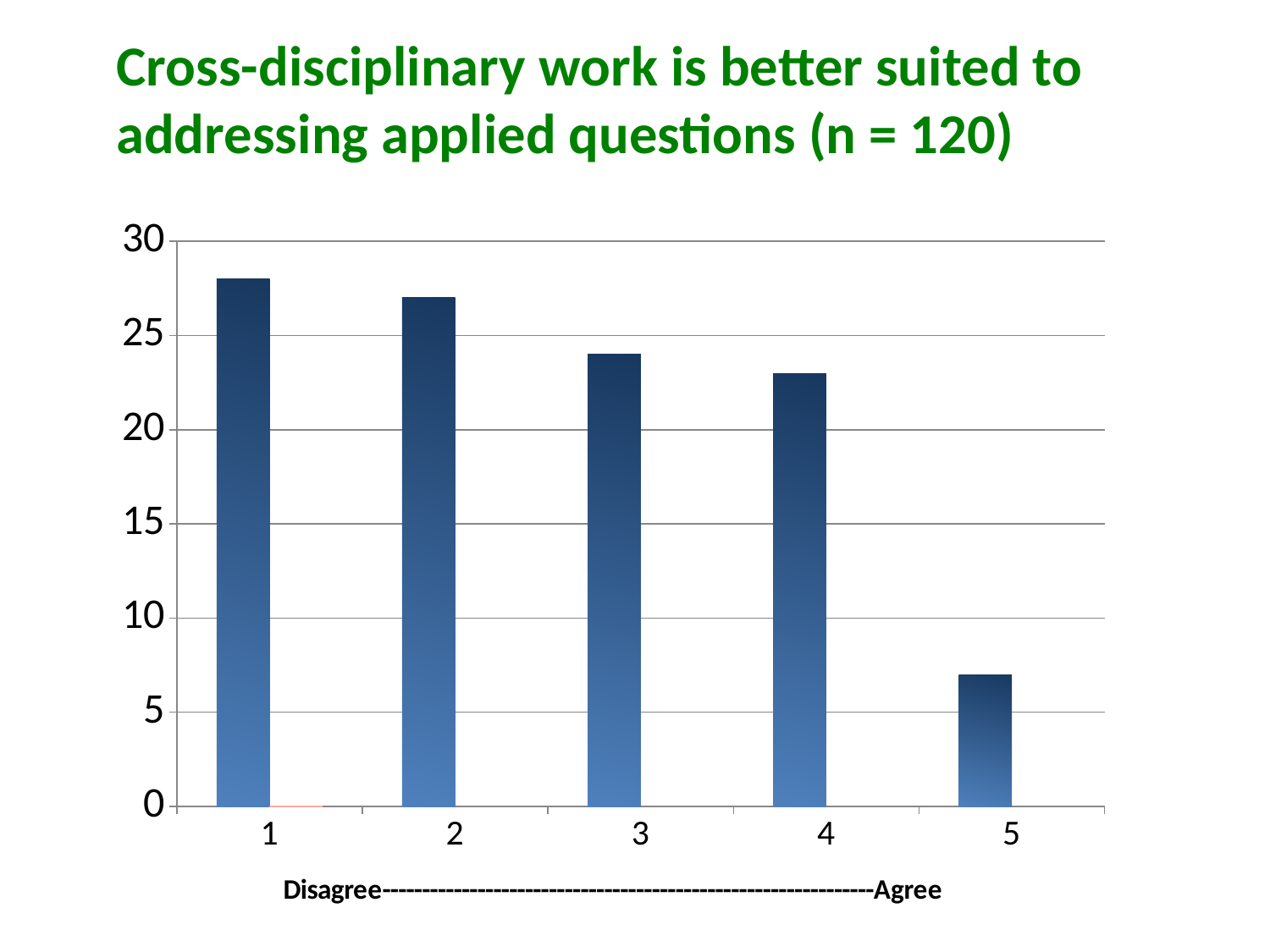
How many categories are shown on the x axis of the chart? 5 Is the value for category 3 greater or less than 25? less What is the sample size given in the chart title? n = 120 Which is larger, the value for category 2 or the value for category 5? 2 Do the bar values rise or fall as you move from category 1 to category 5? fall Is the value for category 2 greater or less than 25? greater Is the value for category 1 greater or less than 25? greater What kind of chart is shown on the slide? bar chart Which category has the lowest bar in the chart? 5 Which is larger, the value for category 1 or the value for category 4? 1